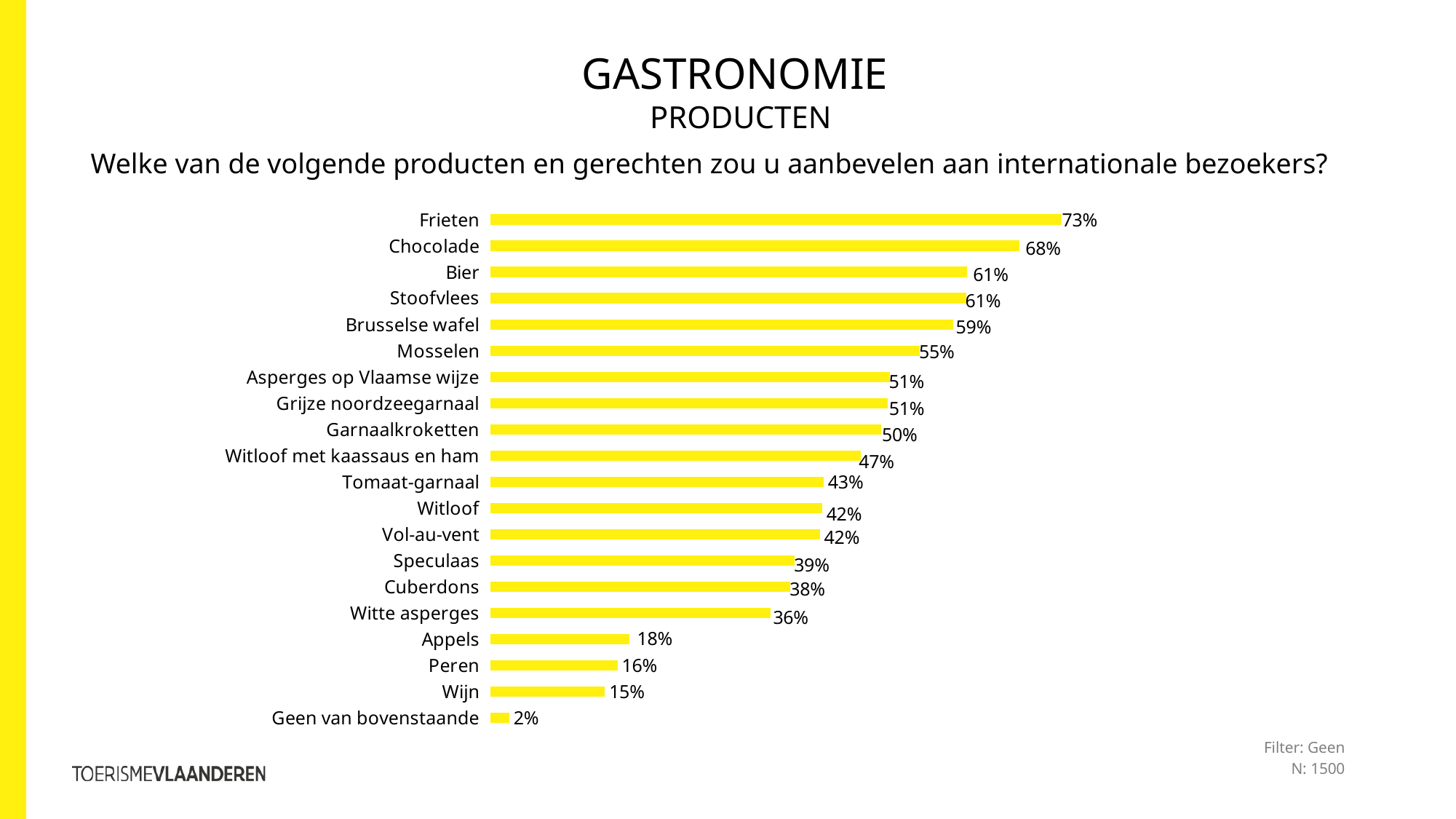
How many categories are shown in the chart? 20 Which is larger, the value for Speculaas or the value for Cuberdons? Speculaas What is the difference between the values for Frieten and Chocolade? 5% What is the value for Witte asperges? 36% What is the difference between the values for Appels and Wijn? 3% Which is larger, the value for Brusselse wafel or the value for Garnaalkroketten? Brusselse wafel What kind of chart is shown on the slide? Bar chart What is the value for Frieten? 73% Which category has the lowest value? Geen van bovenstaande What colour are the bars in the chart? Yellow What is the value for Mosselen? 55% Which category has the highest value? Frieten